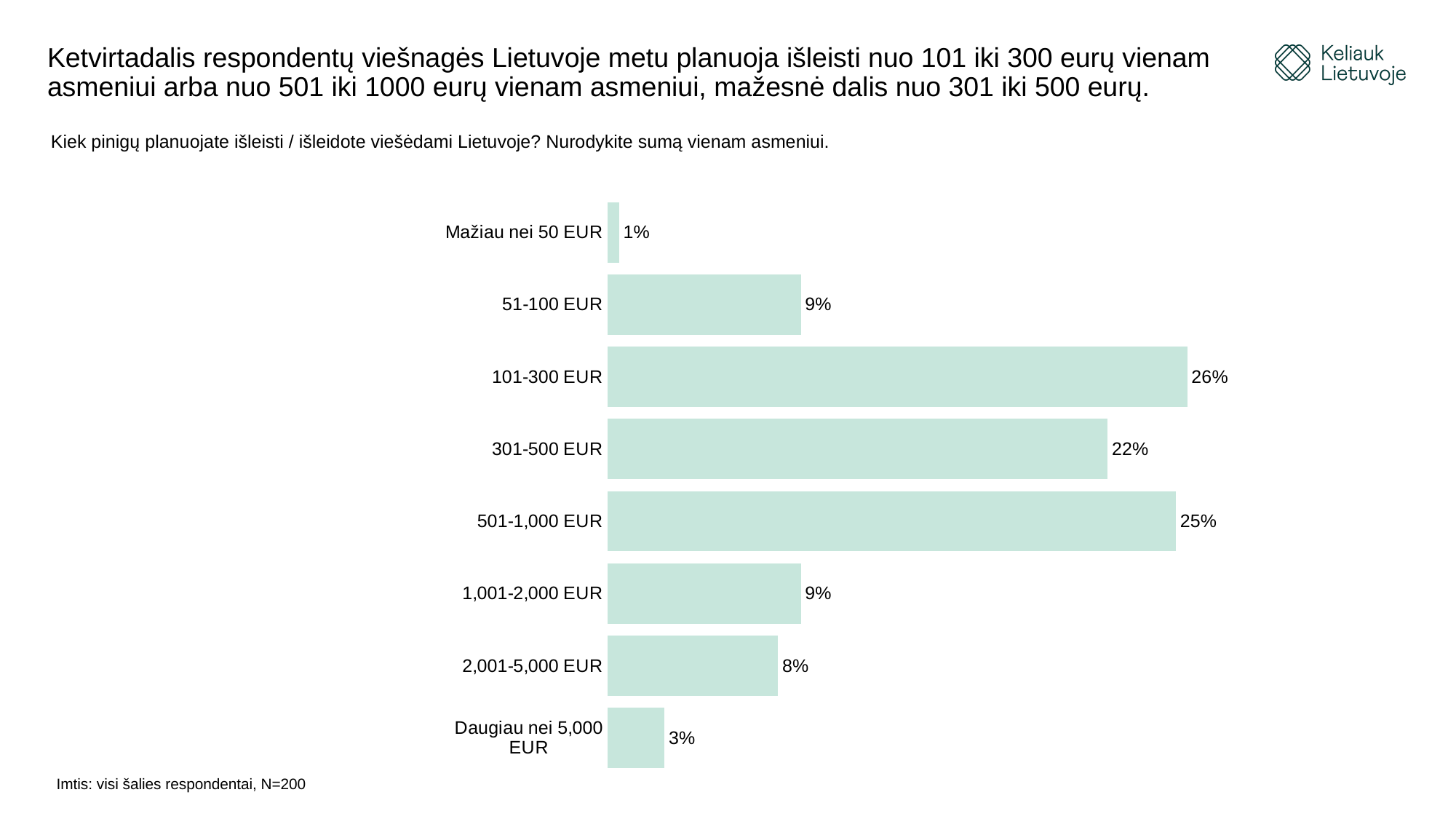
What is the difference in percentage points between the 101-300 EUR and 301-500 EUR categories? 4 Which category has a larger share: 501-1,000 EUR or 1,001-2,000 EUR? 501-1,000 EUR What is the value shown for the 301-500 EUR category? 22% Which spending category has the lowest percentage of respondents? Mažiau nei 50 EUR What is the combined percentage for the 51-100 EUR and 1,001-2,000 EUR categories? 18% What sample size (N) is stated at the bottom of the slide? N=200 What percentage is shown for 'Daugiau nei 5,000 EUR'? 3% What percentage of respondents plan to spend 101-300 EUR per person? 26% What type of chart is shown on the slide? Bar chart How many spending categories are shown in the chart? 8 Which spending category has the highest percentage of respondents? 101-300 EUR What is the value for the 2,001-5,000 EUR category? 8%